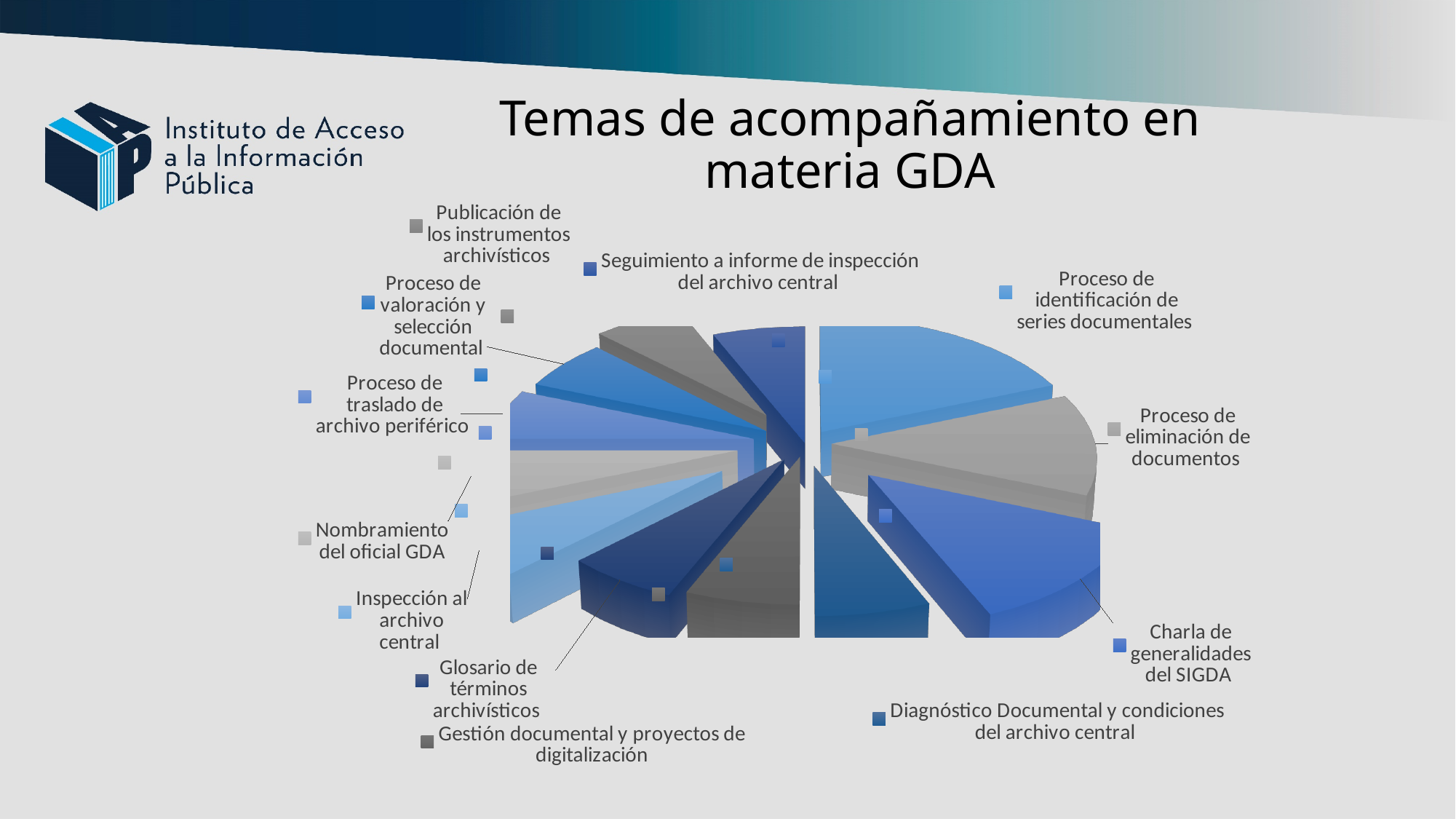
What is the title of the chart on the slide? Temas de acompañamiento en materia GDA What kind of chart is shown on the slide? pie chart Which slice is larger: "Proceso de identificación de series documentales" or "Seguimiento a informe de inspección del archivo central"? Proceso de identificación de series documentales Which slice is larger: "Charla de generalidades del SIGDA" or "Glosario de términos archivísticos"? Charla de generalidades del SIGDA Which slice is larger: "Proceso de identificación de series documentales" or "Nombramiento del oficial GDA"? Proceso de identificación de series documentales Is the chart drawn as a 3D exploded pie or as a flat pie? 3D exploded pie